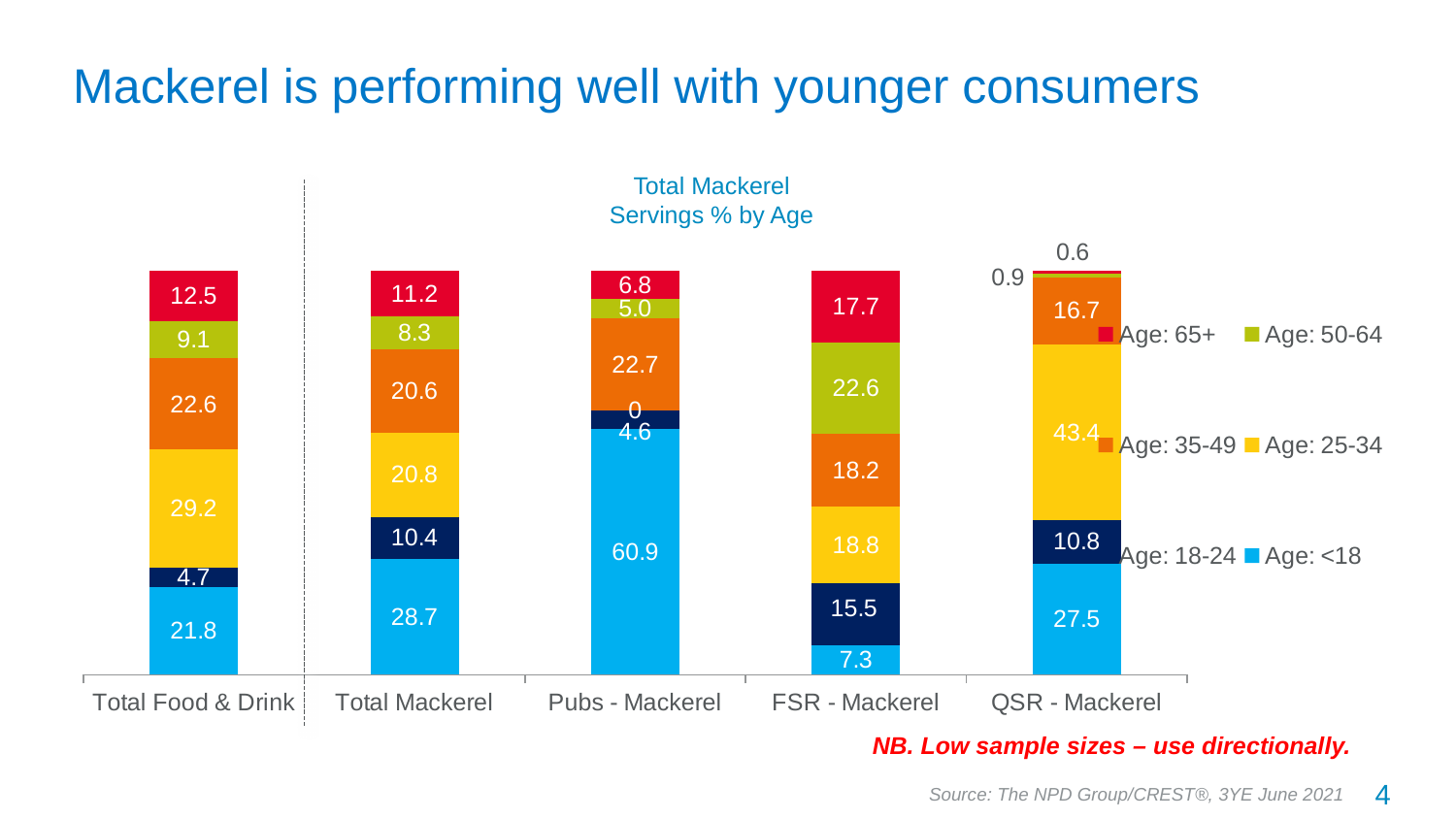
Which category has the highest value for Age: <18? Pubs - Mackerel What kind of chart is shown on the slide? Stacked bar chart What is the value for Age: 65+ in the FSR - Mackerel bar? 17.7 What is the title of the chart? Total Mackerel Servings % by Age What is the value for Age: 25-34 in the QSR - Mackerel bar? 43.4 What is the difference between the Age: <18 values for Total Mackerel and Total Food & Drink? 6.9 What is the value for Age: 18-24 in the Total Food & Drink bar? 4.7 How many categories are shown on the x axis? 5 Which is larger: the Age: 35-49 value for Total Food & Drink or for Total Mackerel? Total Food & Drink How many series does the legend list? 6 Which category has the lowest value for Age: 65+? QSR - Mackerel What is the value for Age: <18 in the Pubs - Mackerel bar? 60.9